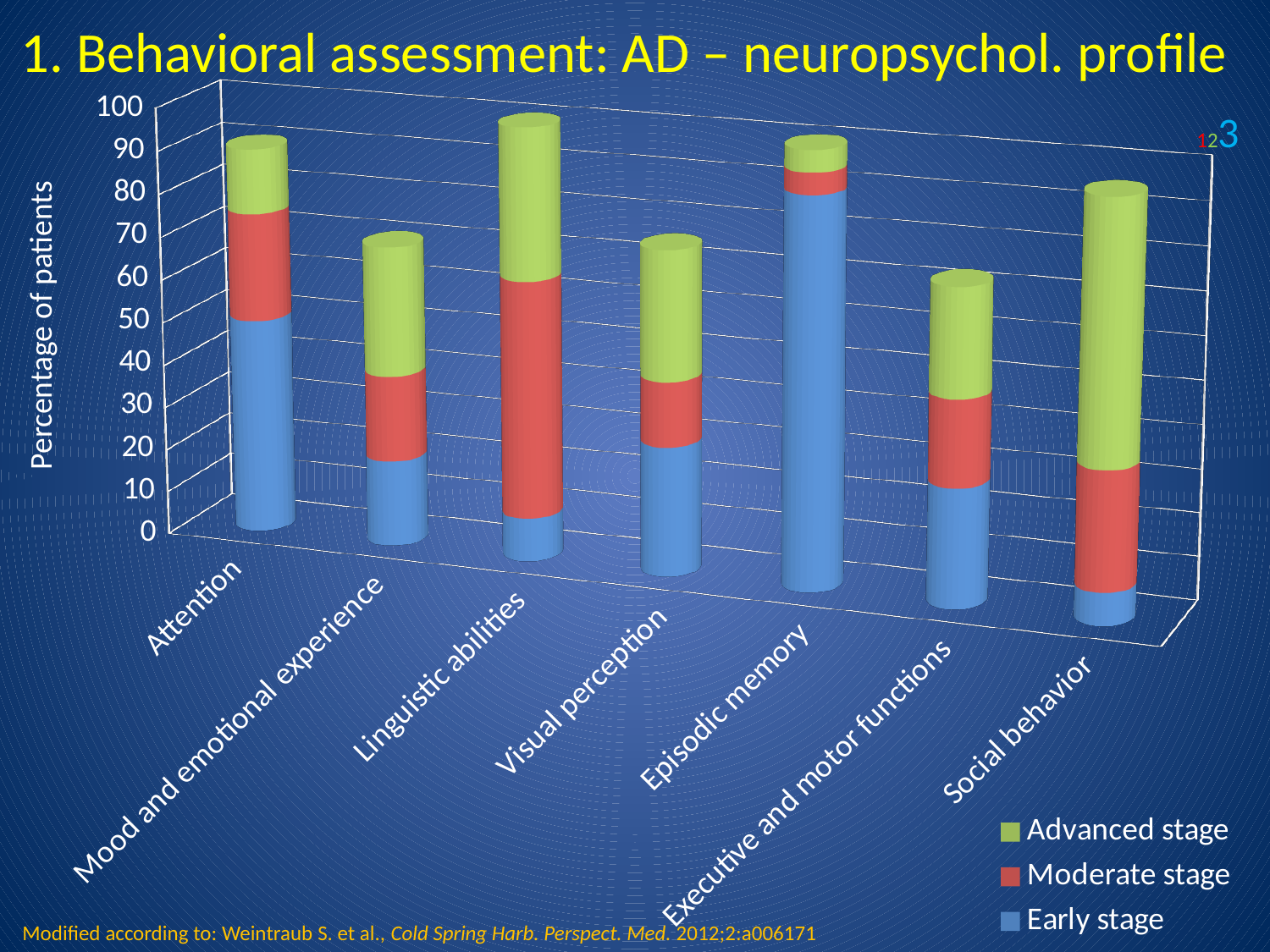
Which category has the largest Moderate stage segment? Linguistic abilities Which category has the largest Early stage segment? Episodic memory Which category has the smallest Early stage segment? Social behavior What is the title of the vertical axis? Percentage of patients Which category has the largest Advanced stage segment? Social behavior How many series does the legend list? 3 Which colour represents the Early stage series? Blue Is the Early stage value for Episodic memory greater or less than 50? greater Is the Early stage value for Social behavior greater or less than 20? less What kind of chart is shown on the slide? Stacked bar chart Which is larger, the Early stage segment for Episodic memory or the Early stage segment for Linguistic abilities? Episodic memory How many categories are plotted along the x axis? 7